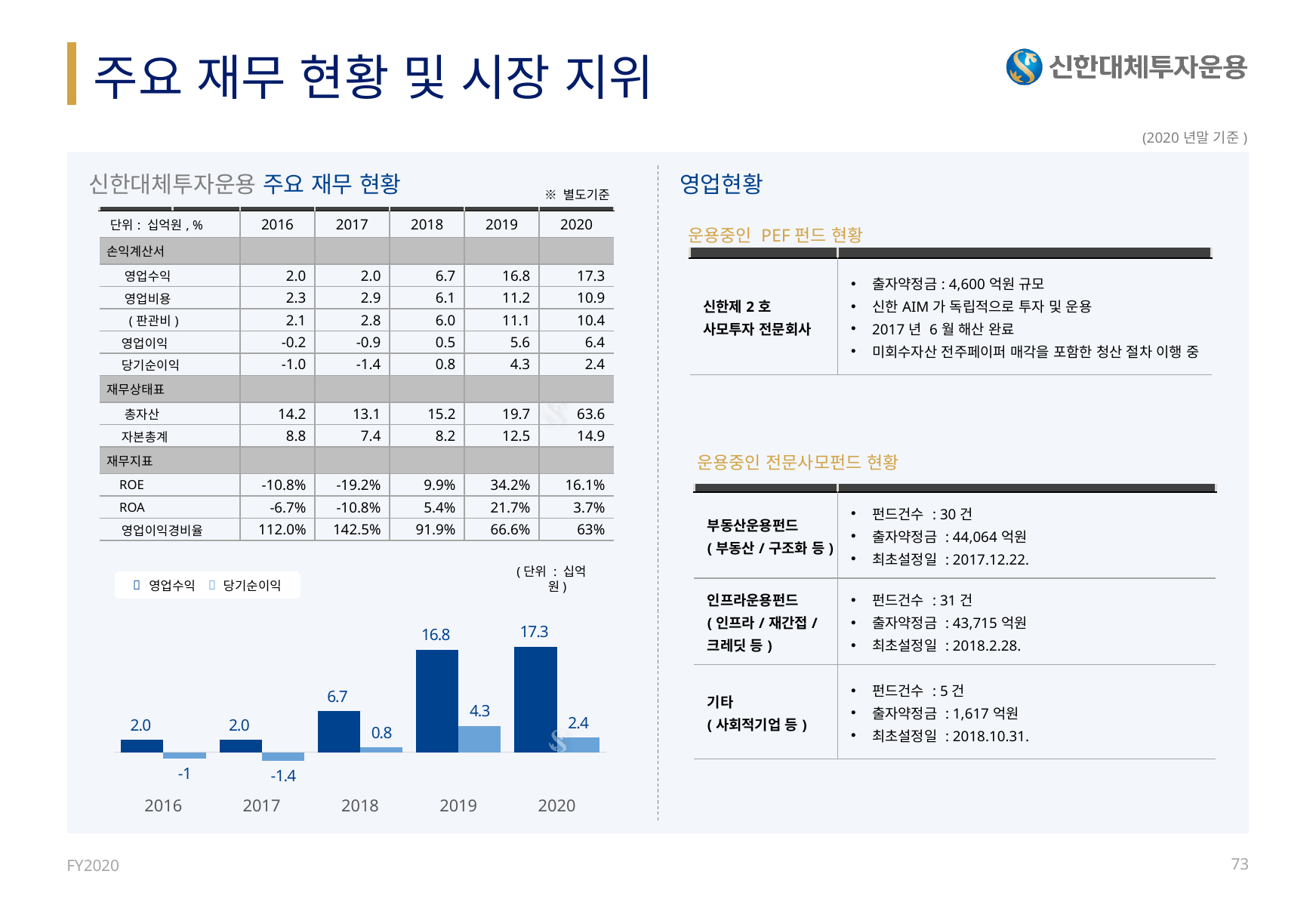
What unit is stated for the values in the chart? 십억원 Which year has the lowest 당기순이익 in the chart? 2017 Which is larger in the chart: 당기순이익 in 2019 or 당기순이익 in 2020? 2019 How many years are shown on the x axis of the chart? 5 Which year has the highest 영업수익 in the chart? 2020 Does 영업수익 rise or fall from 2016 to 2020 in the chart? rise What is the 당기순이익 value for 2020 in the chart? 2.4 What type of chart is shown at the bottom left of the slide? bar chart What is the 당기순이익 value for 2017 in the chart? -1.4 What is the difference between 영업수익 and 당기순이익 in 2019 in the chart? 12.5 How many series does the chart legend list? 2 What is the 영업수익 value for 2019 in the chart? 16.8